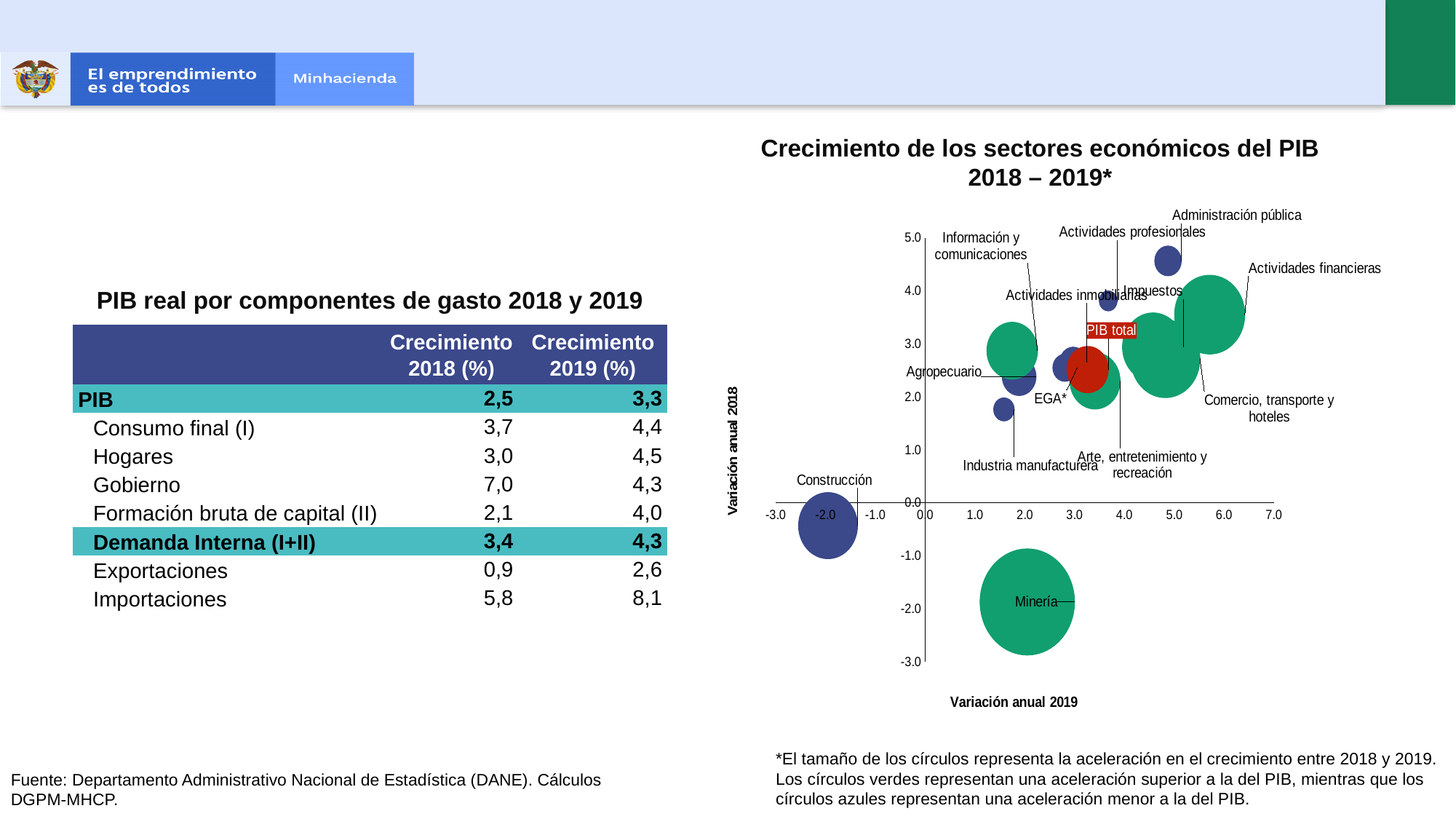
In the bubble chart, which sector has the lowest value on the vertical axis (Variación anual 2018)? Minería In the bubble chart, is the 2019 value (horizontal axis) for Construcción greater or less than 0.0? less In the bubble chart, which sector has the lowest value on the horizontal axis (Variación anual 2019)? Construcción In the bubble chart, is the 2018 value (vertical axis) for Minería greater or less than 0.0? less What kind of chart is 'Crecimiento de los sectores económicos del PIB 2018 – 2019*'? bubble chart In the bubble chart, is the 2019 value (horizontal axis) for Actividades financieras greater or less than 5.0? greater In the bubble chart, what is the title of the vertical axis? Variación anual 2018 In the bubble chart, which has the larger value on the horizontal axis (Variación anual 2019): Minería or Construcción? Minería In the bubble chart, what is the title of the horizontal axis? Variación anual 2019 In the bubble chart, which sector has the highest value on the vertical axis (Variación anual 2018)? Administración pública